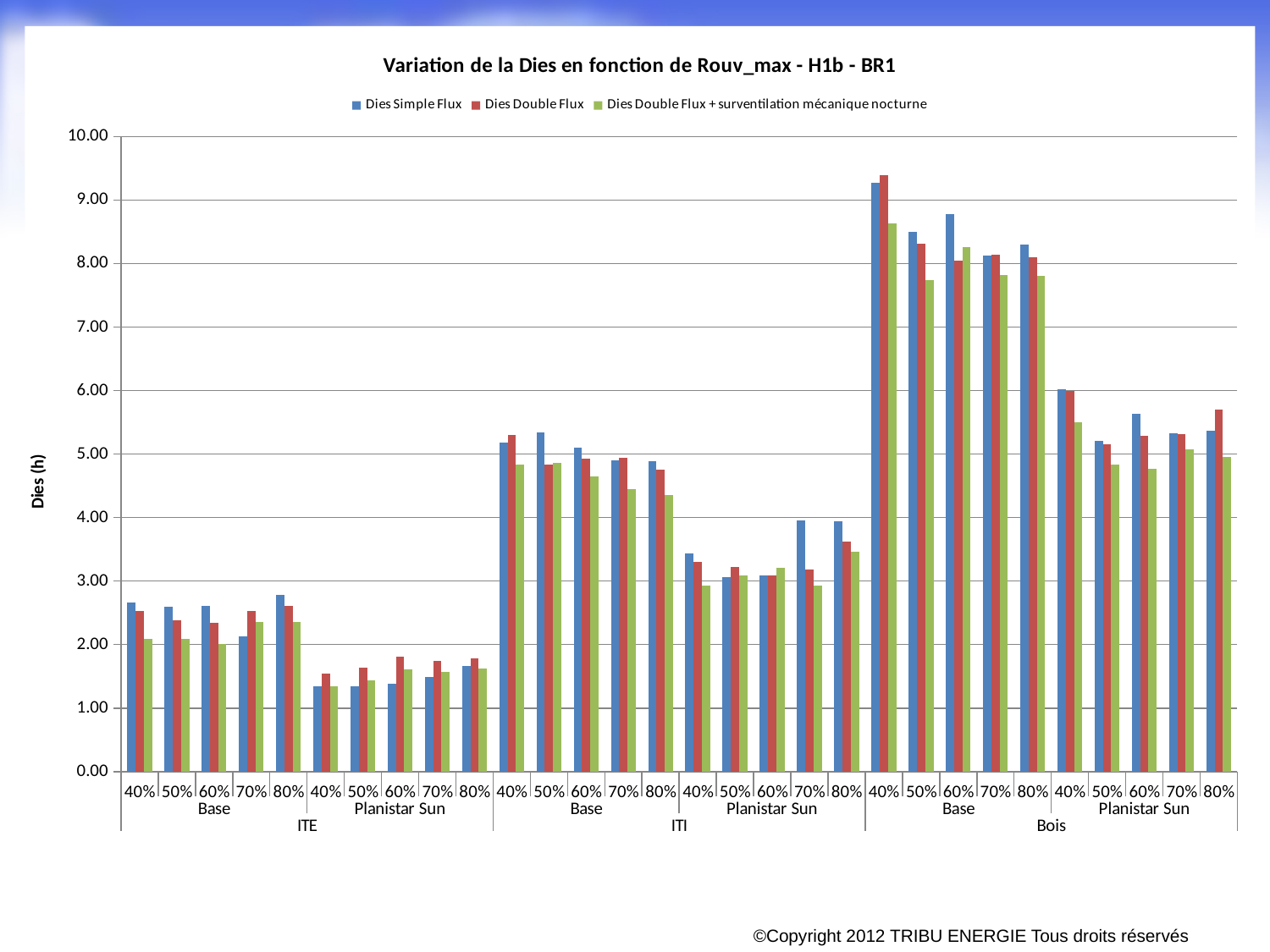
What kind of chart is shown on the slide? bar chart Is the Dies Simple Flux value for ITI / Base / 40% greater or less than 5.00? greater How many series does the legend list? 3 What is the label of the vertical axis? Dies (h) What is the title of the chart? Variation de la Dies en fonction de Rouv_max - H1b - BR1 For ITE / Base / 40%, which is larger: Dies Simple Flux or Dies Double Flux + surventilation mécanique nocturne? Dies Simple Flux Which wall type group (ITE, ITI or Bois) has the highest Dies values overall? Bois Is the Dies Simple Flux value for Bois / Base / 40% greater or less than 9.00? greater For ITI / Planistar Sun / 70%, which is larger: Dies Simple Flux or Dies Double Flux? Dies Simple Flux How many percentage categories (bar groups) are plotted along the x axis in total? 30 Is the Dies Simple Flux value for ITE / Planistar Sun / 40% greater or less than 2.00? less Which series has the highest bar in the whole chart, found at Bois / Base / 40%? Dies Double Flux